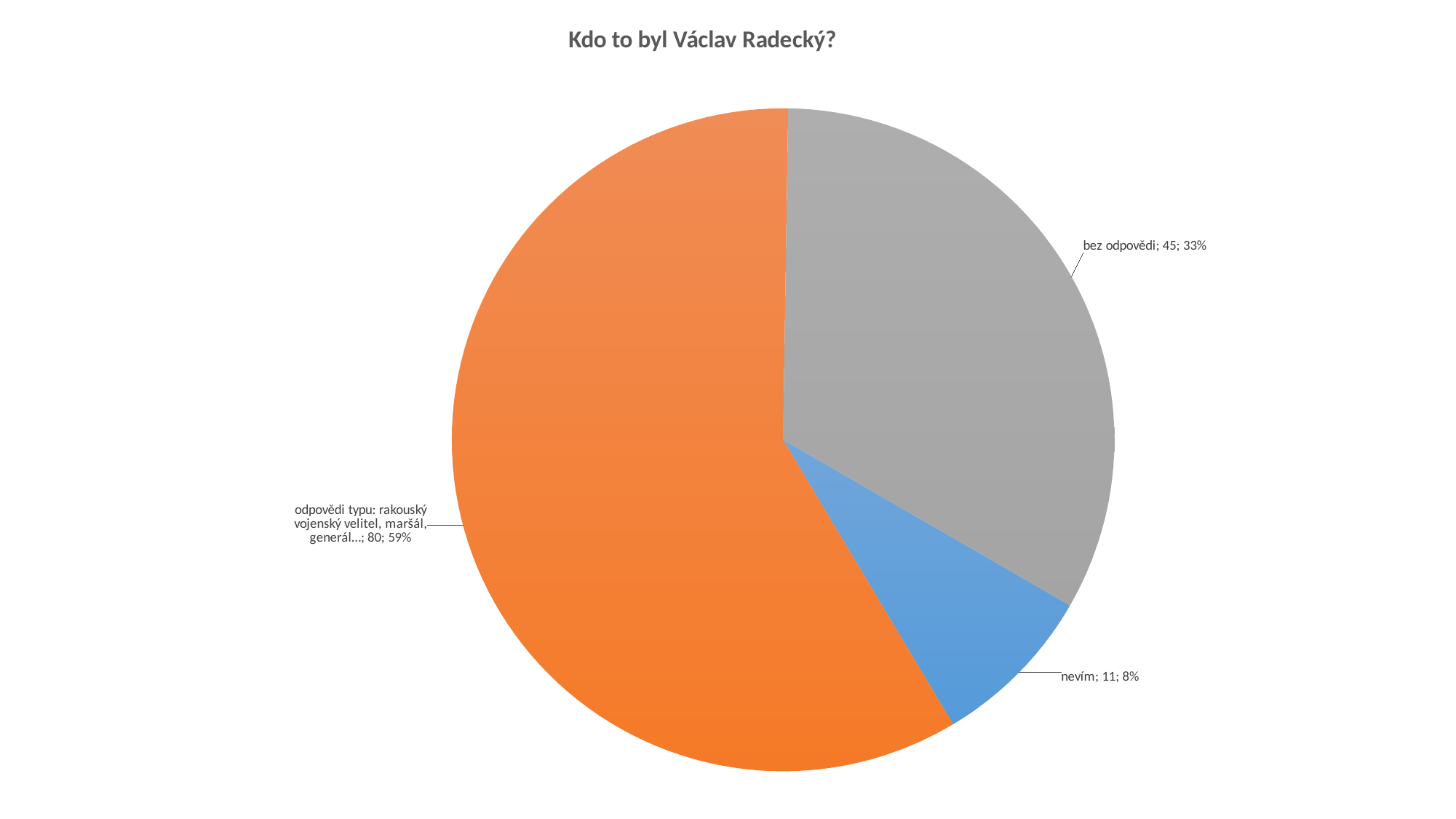
What is the title of the chart? Kdo to byl Václav Radecký? What share of the pie does "nevím" represent? 8% How many slices does the pie chart have? 3 What share of the pie does "odpovědi typu: rakouský vojenský velitel, maršál, generál..." represent? 59% What is the count for "bez odpovědi"? 45 What is the difference between the counts for "bez odpovědi" and "nevím"? 34 What is the count for "nevím"? 11 What kind of chart is shown on the slide? pie chart Which category has the smallest slice? nevím What is the count for "odpovědi typu: rakouský vojenský velitel, maršál, generál..."? 80 What share of the pie does "bez odpovědi" represent? 33% Which category has the largest slice? odpovědi typu: rakouský vojenský velitel, maršál, generál...